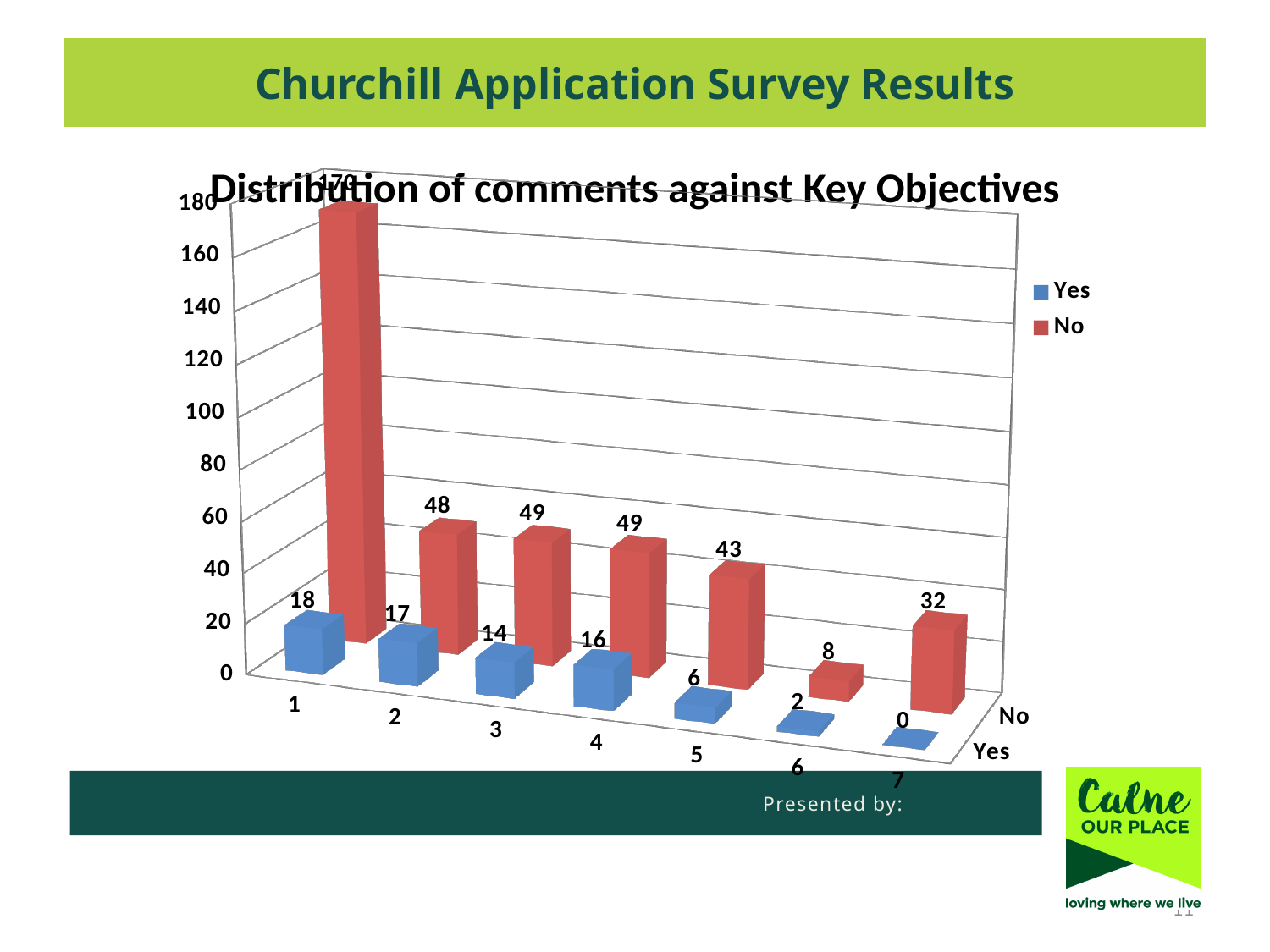
Which category has the larger No value, category 2 or category 7? 2 What is the Yes value for category 3? 14 What is the No value for category 6? 8 What is the No value for category 2? 48 Which category has the lowest Yes value? 7 What kind of chart is shown on the slide? bar chart What is the Yes value for category 7? 0 Which category has the highest No value? 1 For category 5, how much larger is the No value than the Yes value? 37 How many series does the legend list? 2 Is the No value for category 1 greater or less than 160? greater How many categories are shown on the x axis? 7